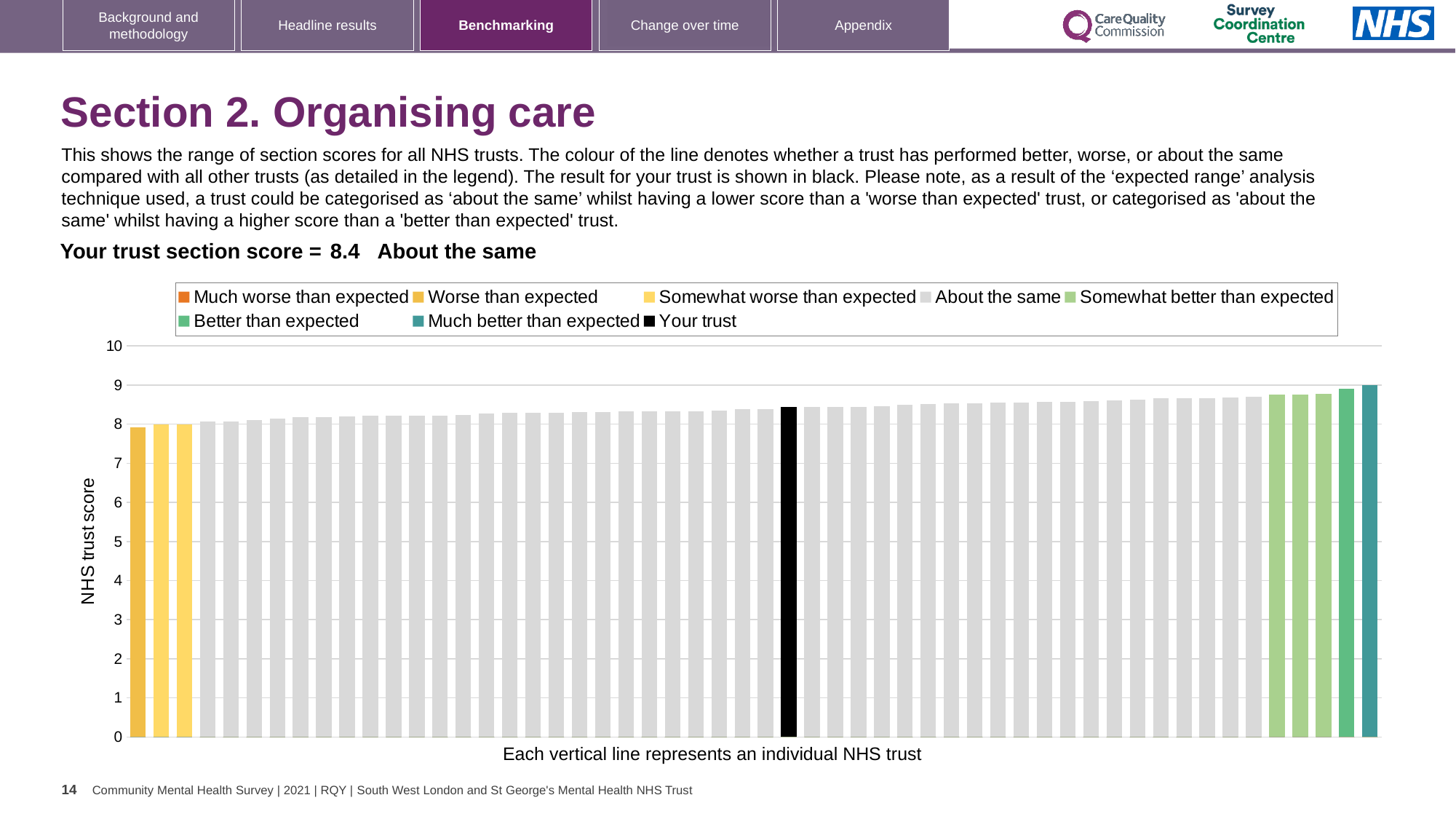
What colour is the bar representing your trust? black What is the section score for your trust? 8.4 How many bars are in the 'Much better than expected' category? 1 Do the bar values rise or fall from left to right along the x axis? rise What kind of chart is shown on the slide? bar chart What is the label of the y axis? NHS trust score Is the value for your trust greater or less than 9? less What is the highest value shown on the y axis? 10 Which legend category does the tallest bar belong to? Much better than expected Is the value of the tallest bar greater or less than 8? greater Is the value for your trust greater or less than 8? greater How many entries does the chart legend list? 8